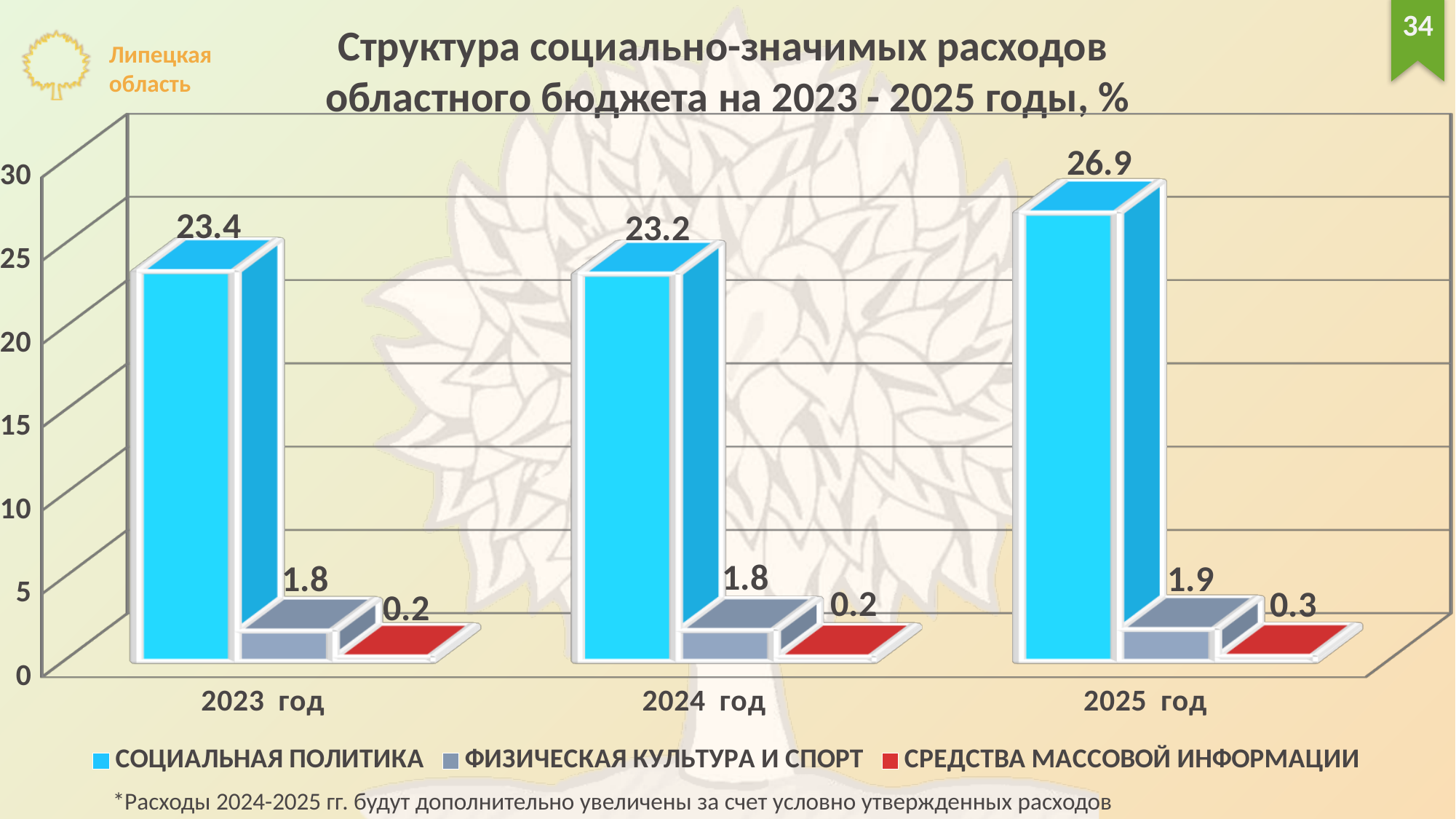
How many series does the legend list? 3 What is the value for СОЦИАЛЬНАЯ ПОЛИТИКА in 2025 год? 26.9 Is the value for СОЦИАЛЬНАЯ ПОЛИТИКА in 2025 год greater or less than 25? greater What is the value for СОЦИАЛЬНАЯ ПОЛИТИКА in 2023 год? 23.4 Which is larger: СРЕДСТВА МАССОВОЙ ИНФОРМАЦИИ in 2025 год or in 2023 год? 2025 год In which year is the value for СОЦИАЛЬНАЯ ПОЛИТИКА lowest? 2024 год What is the difference between the СОЦИАЛЬНАЯ ПОЛИТИКА values for 2025 год and 2023 год? 3.5 In which year is the value for СОЦИАЛЬНАЯ ПОЛИТИКА highest? 2025 год What is the value for ФИЗИЧЕСКАЯ КУЛЬТУРА И СПОРТ in 2025 год? 1.9 What kind of chart is shown on the slide? bar chart What is the value for СРЕДСТВА МАССОВОЙ ИНФОРМАЦИИ in 2024 год? 0.2 How many years are shown on the x axis? 3